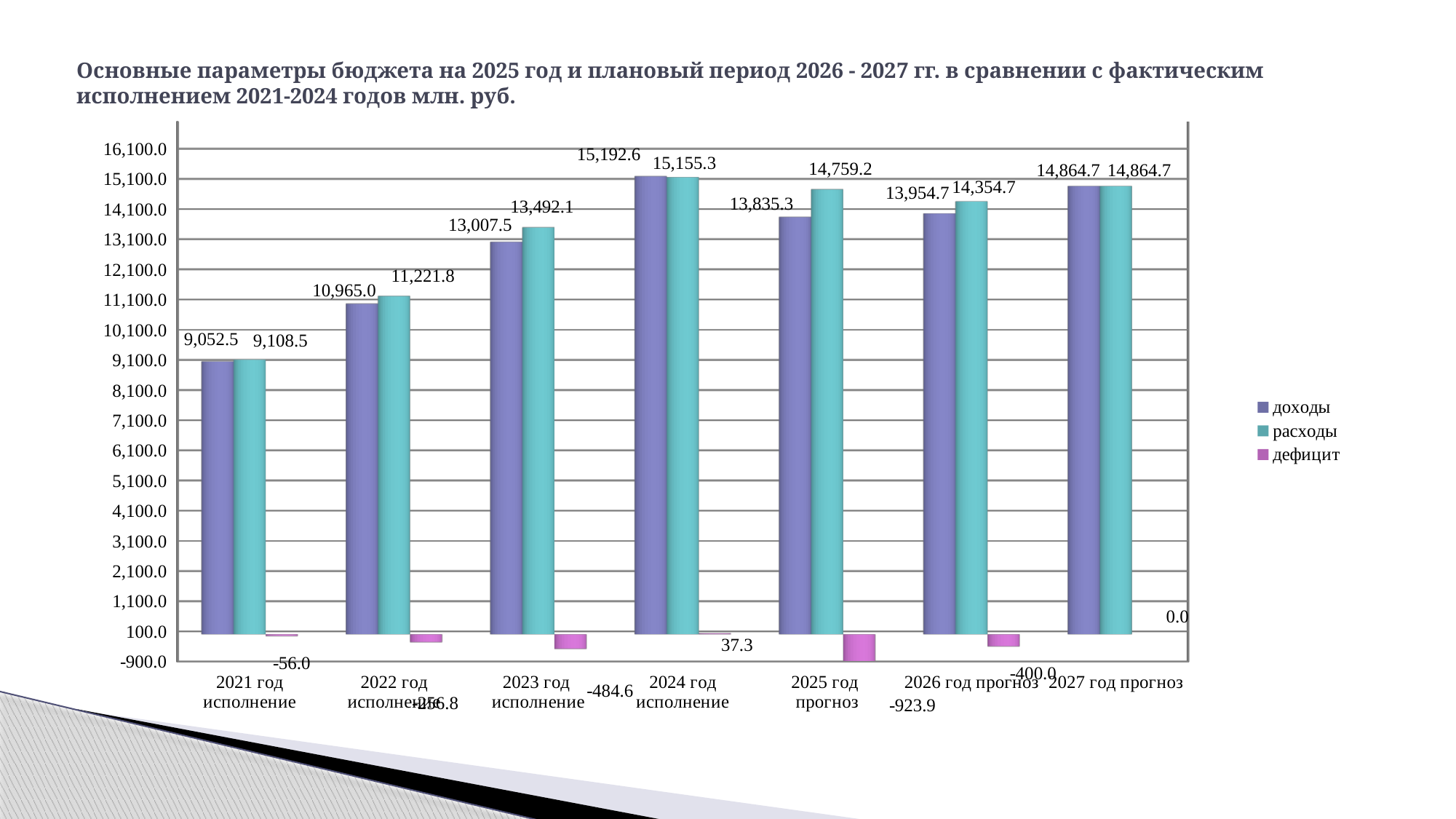
What is the value of дефицит for 2023 год исполнение? -484.6 What is the difference between расходы and доходы for 2026 год прогноз? 400.0 What is the value of доходы for 2024 год исполнение? 15,192.6 How many categories are shown on the x axis? 7 Which category has the lowest value of расходы? 2021 год исполнение What kind of chart is shown on the slide? bar chart Which category has the highest value of доходы? 2024 год исполнение Is the value of доходы for 2022 год исполнение greater or less than 12,100.0? less What is the value of расходы for 2025 год прогноз? 14,759.2 How many series does the legend list? 3 What is the value of дефицит for 2027 год прогноз? 0.0 Which is larger for 2024 год исполнение, доходы or расходы? доходы